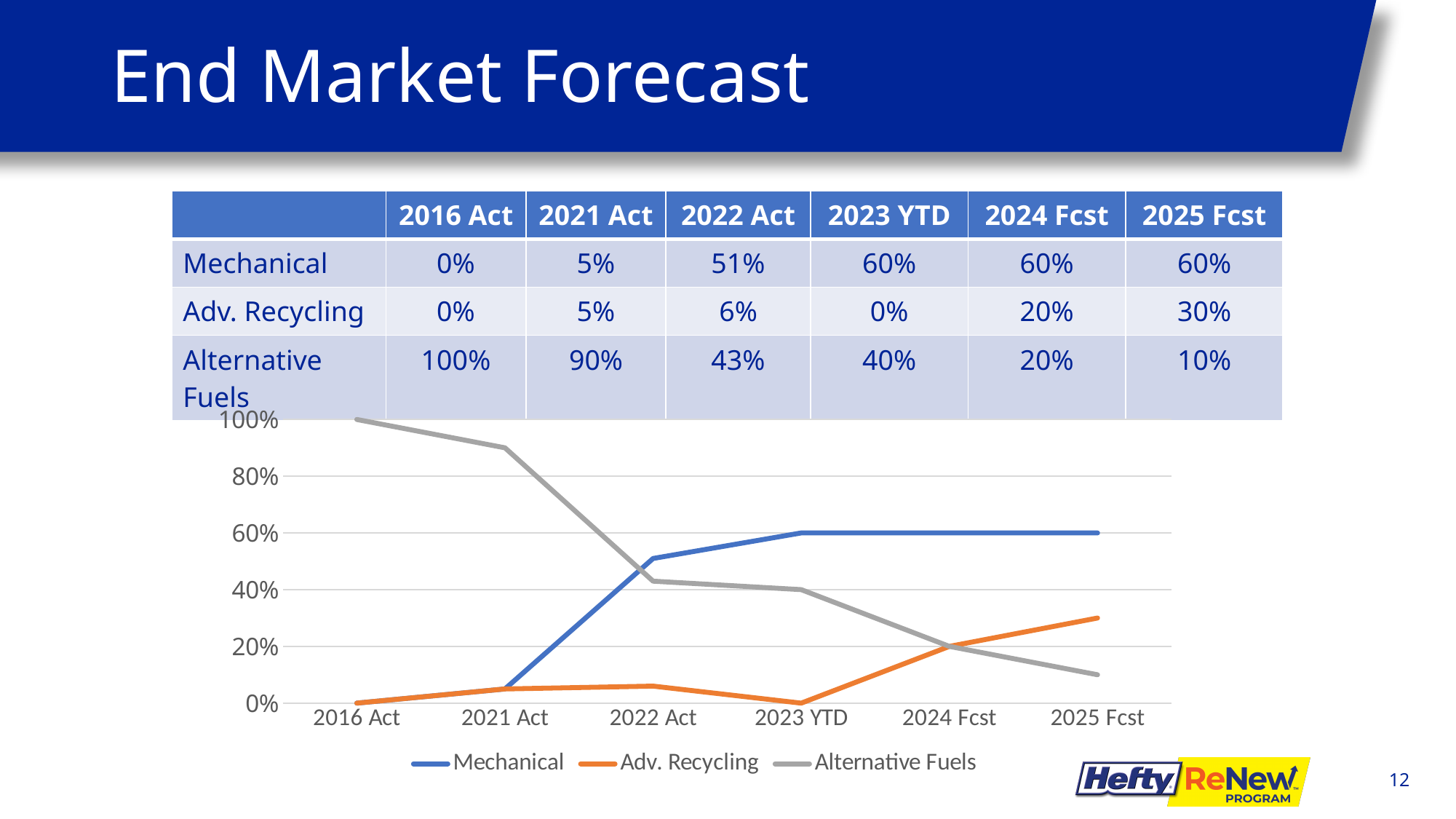
How many series does the chart legend list? 3 What is the value for Mechanical in 2022 Act? 51% Which colour is used for the Adv. Recycling line in the chart? orange What is the value for Adv. Recycling in 2025 Fcst? 30% Does the Alternative Fuels line rise or fall from 2016 Act to 2025 Fcst? fall What is the difference between Mechanical and Adv. Recycling in 2025 Fcst? 30% In which period is Alternative Fuels lowest? 2025 Fcst What is the value for Alternative Fuels in 2021 Act? 90% How many points are plotted along the x axis of the chart? 6 In which period is Alternative Fuels highest? 2016 Act What kind of chart is shown on the slide? line chart Which is larger in 2023 YTD, Mechanical or Alternative Fuels? Mechanical